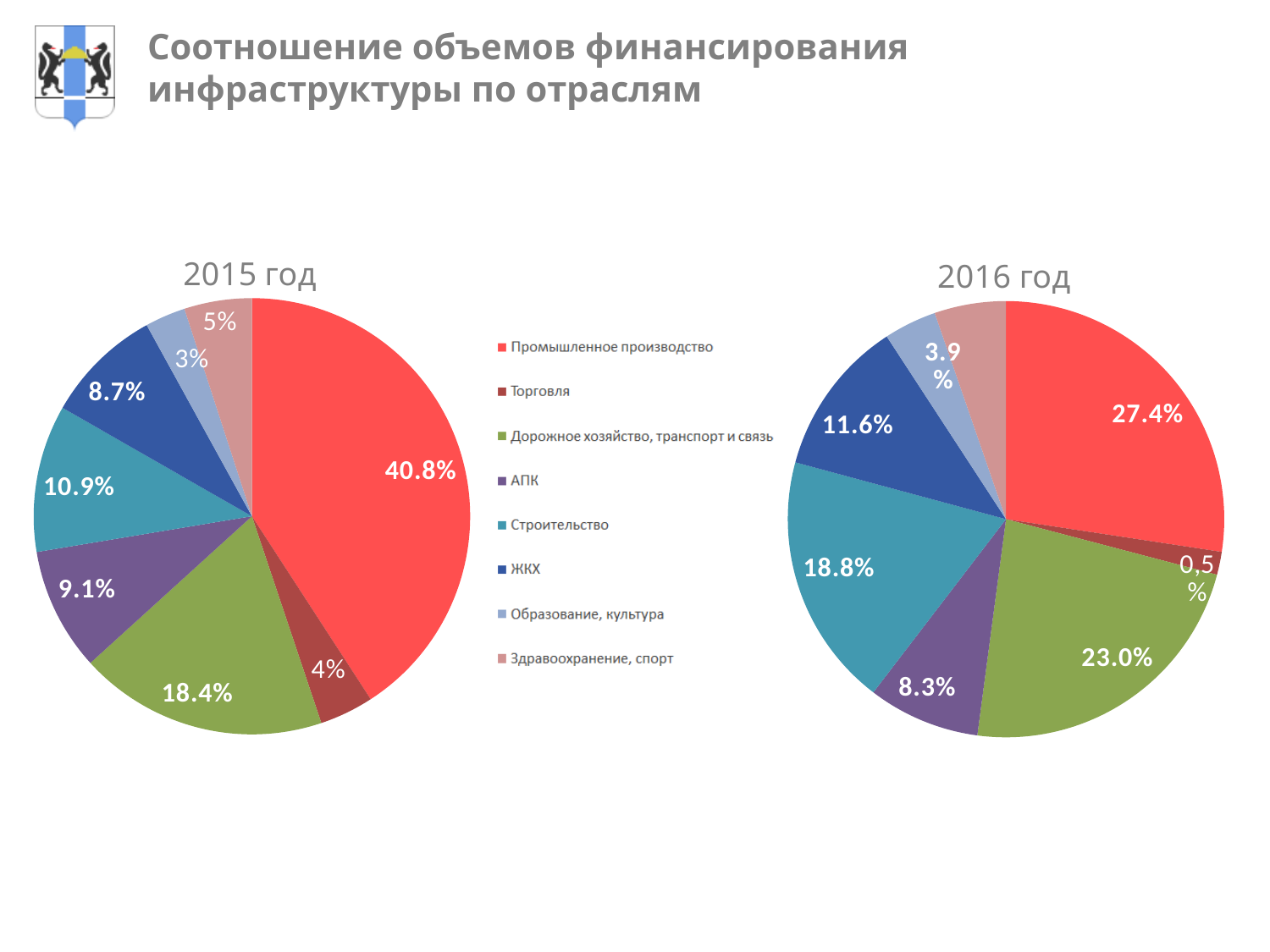
In the 2015 год pie chart, what share does ЖКХ have? 8.7% In the 2016 год pie chart, which category has the smallest slice? Торговля In the 2016 год pie chart, what share does Строительство have? 18.8% What type of chart is used for the 2015 год and 2016 год data? Pie chart In the 2016 год pie chart, what share does Дорожное хозяйство, транспорт и связь have? 23.0% In the 2016 год pie chart, which is larger: the slice for Строительство or the slice for ЖКХ? Строительство In the 2015 год pie chart, which category has the largest slice? Промышленное производство How many categories does the legend list? 8 In the 2015 год pie chart, which category has the smallest slice? Образование, культура What is the difference between the share of Промышленное производство in the 2015 год chart and in the 2016 год chart? 13.4% In the 2015 год pie chart, what share does Промышленное производство have? 40.8% Which colour represents АПК in the pie charts? Purple